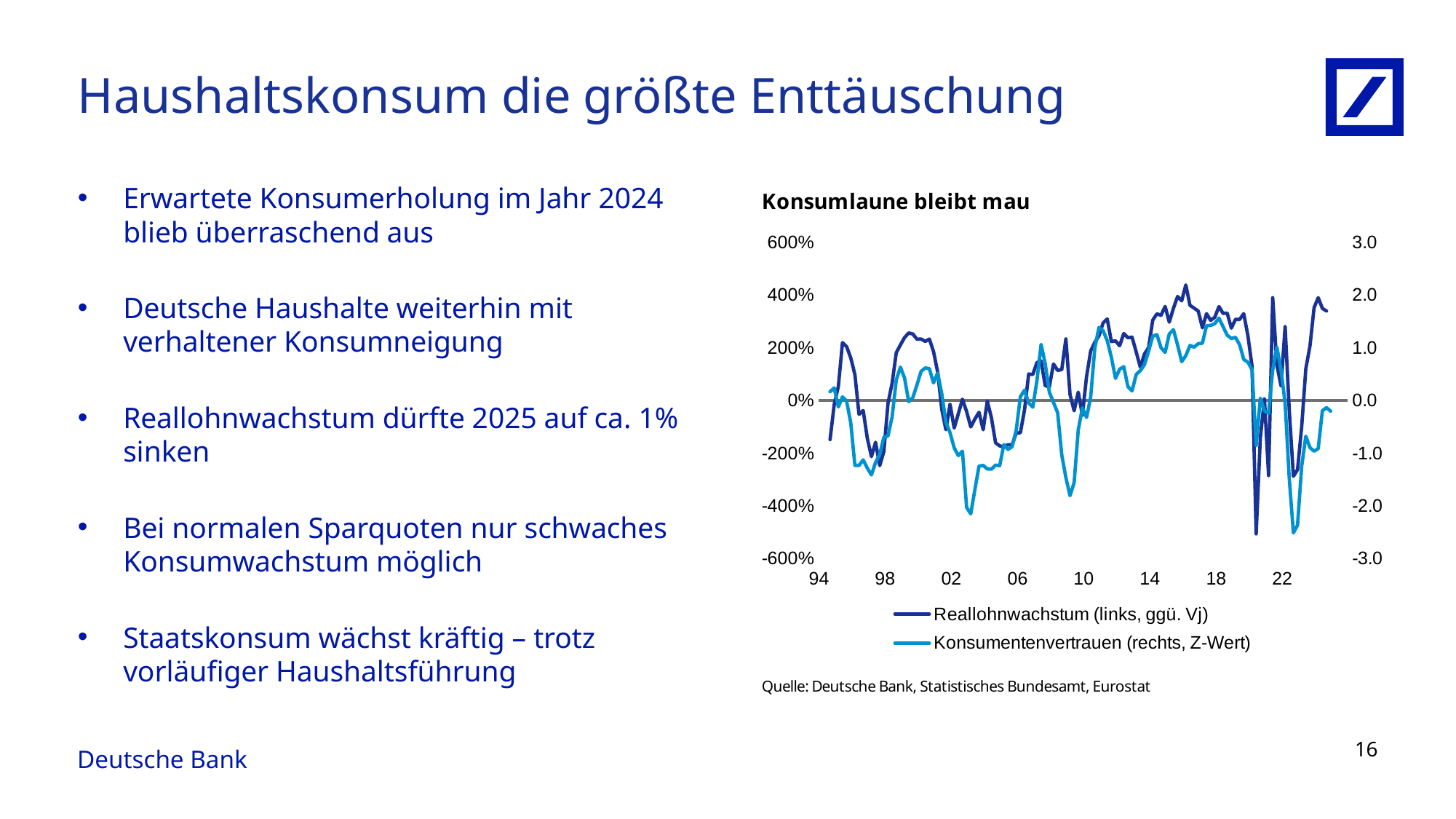
Is the peak value of Reallohnwachstum around 2016 greater or less than 400%? greater Is the lowest value of Reallohnwachstum around 2020 greater or less than -400%? less Is the value of Konsumentenvertrauen at the end of the series (after 22) greater or less than 1.0? less Does Reallohnwachstum rise or fall from its low around 2022 to the end of the series? rise What is the title of the chart? Konsumlaune bleibt mau How many series does the legend of the chart list? 2 Which series in the chart is plotted against the right axis? Konsumentenvertrauen (rechts, Z-Wert) What kind of chart is shown on the slide? line chart